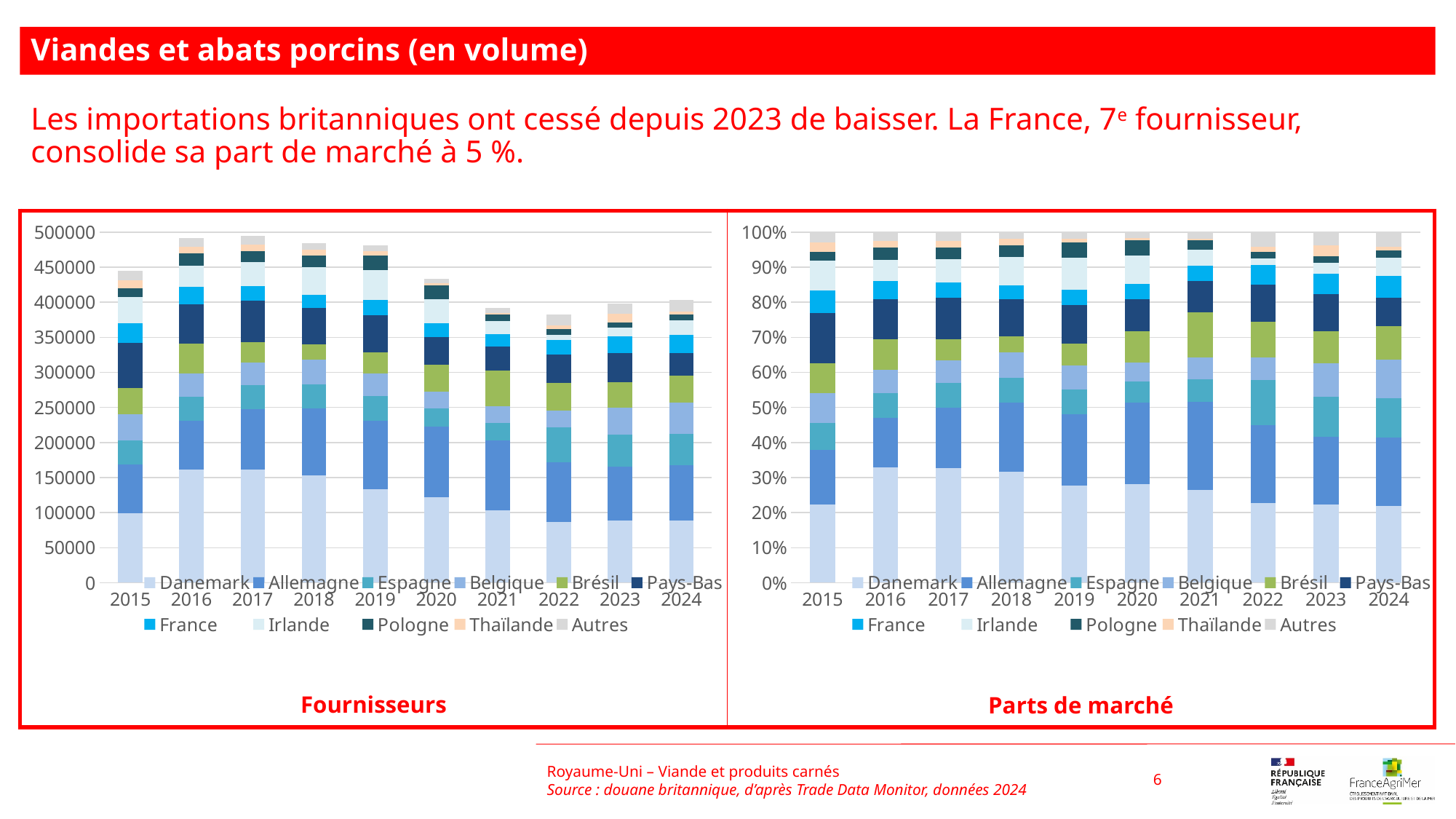
In the 'Parts de marché' chart, is the Danemark share for 2024 greater or less than 30%? less In the 'Fournisseurs' chart, is the Danemark segment for 2016 greater or less than 150000? greater How many years are shown on the x axis of the 'Parts de marché' chart? 10 How many series does the legend of the 'Fournisseurs' chart list? 11 In the 'Fournisseurs' chart, is the total bar for 2016 greater or less than 450000? greater In the 'Fournisseurs' chart, do the total bars rise or fall from 2017 to 2022? fall What is the title of the chart on the right of the slide? Parts de marché What kind of chart is the 'Fournisseurs' chart on the left? stacked bar chart